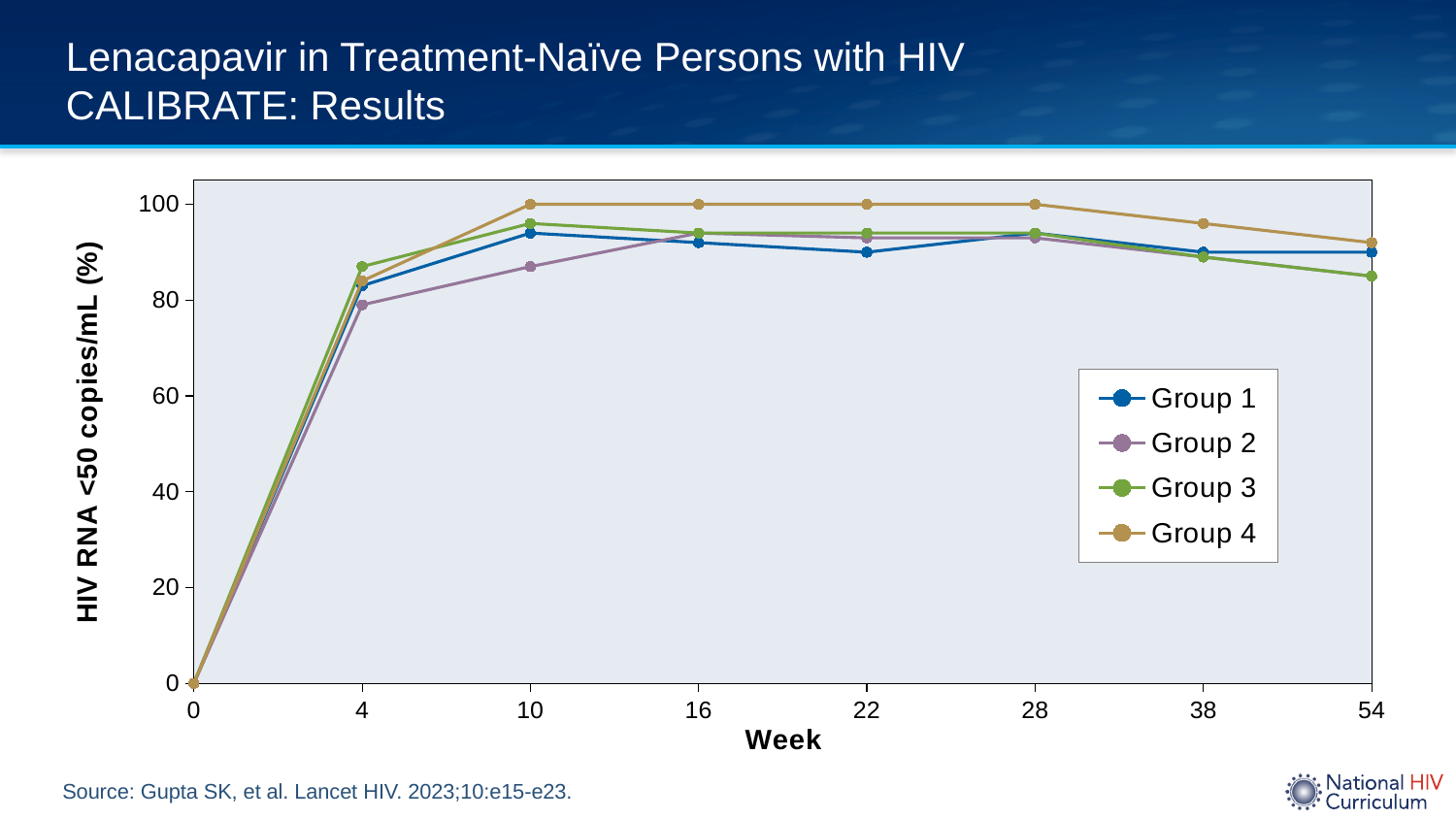
Is the value for Group 2 at week 10 greater or less than 80? greater What kind of chart is shown on the slide? line chart Do the values rise or fall between week 0 and week 10? rise What is the label on the y axis? HIV RNA <50 copies/mL (%) What is the value for Group 1 at week 0? 0 How many series does the legend list? 4 At week 4, which is larger: the value for Group 4 or the value for Group 2? Group 4 Which group has the highest value at week 10? Group 4 Is the value for Group 3 at week 54 greater or less than 80? greater What is the value for Group 4 at week 10? 100 Which group has the lowest value at week 10? Group 2 How many week time points are plotted along the x axis? 8